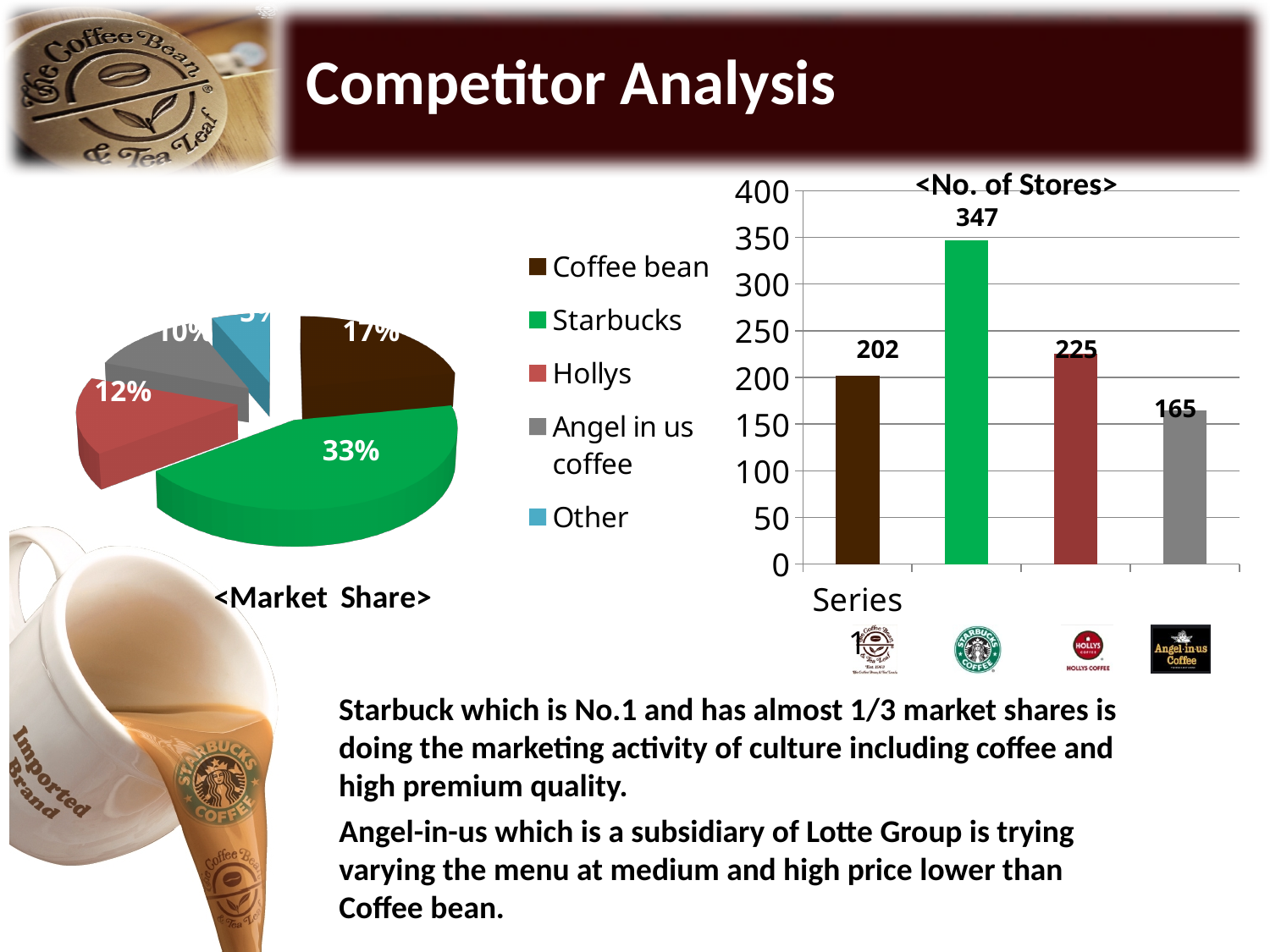
In the <Market Share> pie chart, which company has the largest slice? Starbucks In the <Market Share> pie chart, what share does Starbucks have? 33% What kind of chart is the <No. of Stores> chart? bar chart In the <No. of Stores> chart, what is the value of the third (red) bar from the left? 225 In the <No. of Stores> chart, is the value of the green bar greater or less than 300? greater In the <No. of Stores> chart, how many bars are plotted? 4 In the <No. of Stores> chart, what is the value of the first (brown) bar from the left? 202 In the <No. of Stores> chart, what is the value of the shortest bar? 165 In the <No. of Stores> chart, what is the value of the tallest bar? 347 In the <Market Share> pie chart, what share does Coffee bean have? 17% In the <No. of Stores> chart, what is the difference between the green bar (347) and the brown bar (202)? 145 How many entries does the legend of the <Market Share> pie chart list? 5